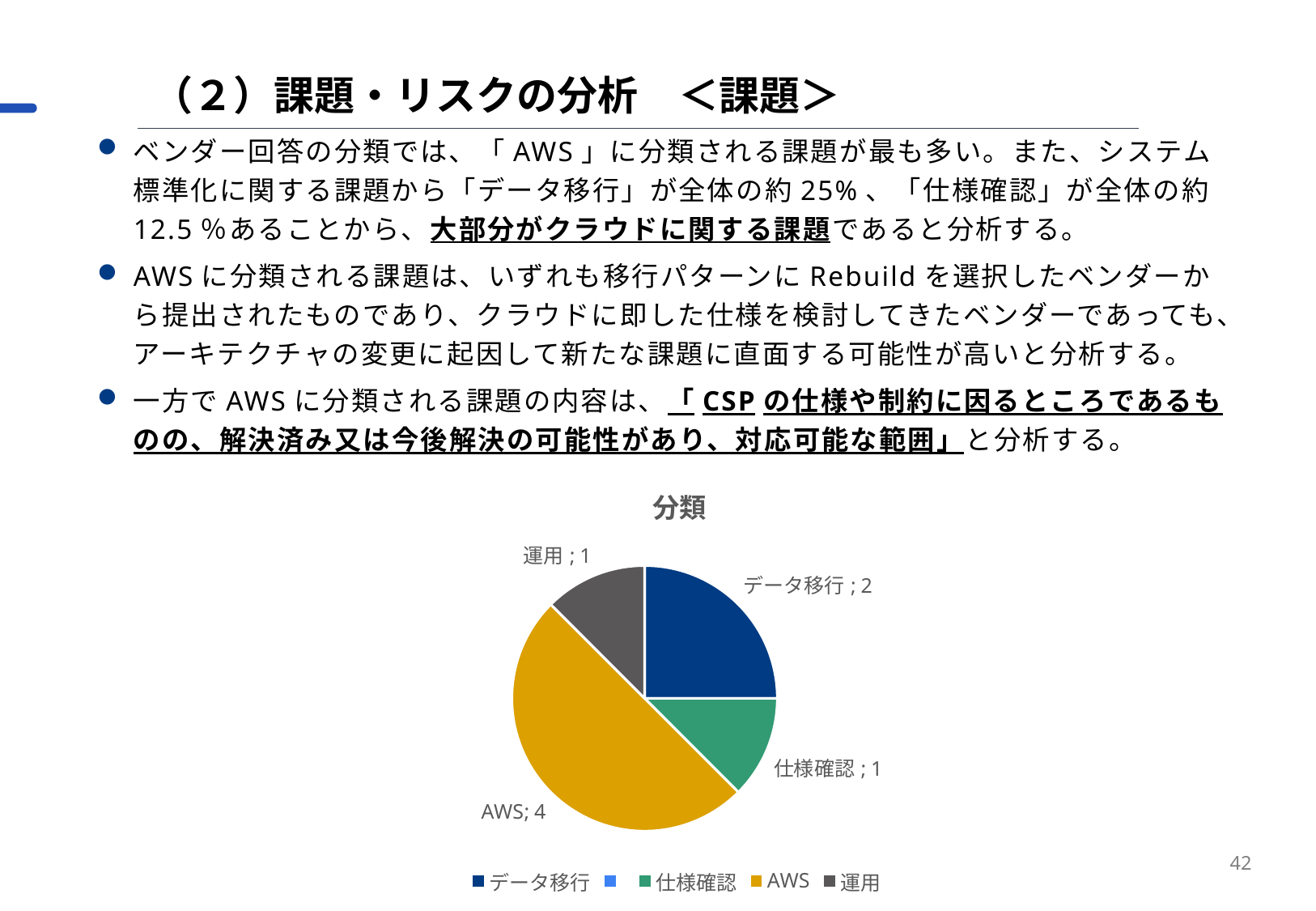
What is the value for AWS in the pie chart? 4 What is the value for データ移行 in the pie chart? 2 What is the difference between the values for AWS and データ移行? 2 What kind of chart is shown on the slide? pie chart How many slices does the pie chart have? 4 What is the value for 運用 in the pie chart? 1 What share of the pie does AWS represent? 50% What is the value for 仕様確認 in the pie chart? 1 What is the title of the chart? 分類 What share of the pie does データ移行 represent? 25% Which category has the largest slice in the pie chart? AWS Which is larger, the value for データ移行 or the value for 仕様確認? データ移行